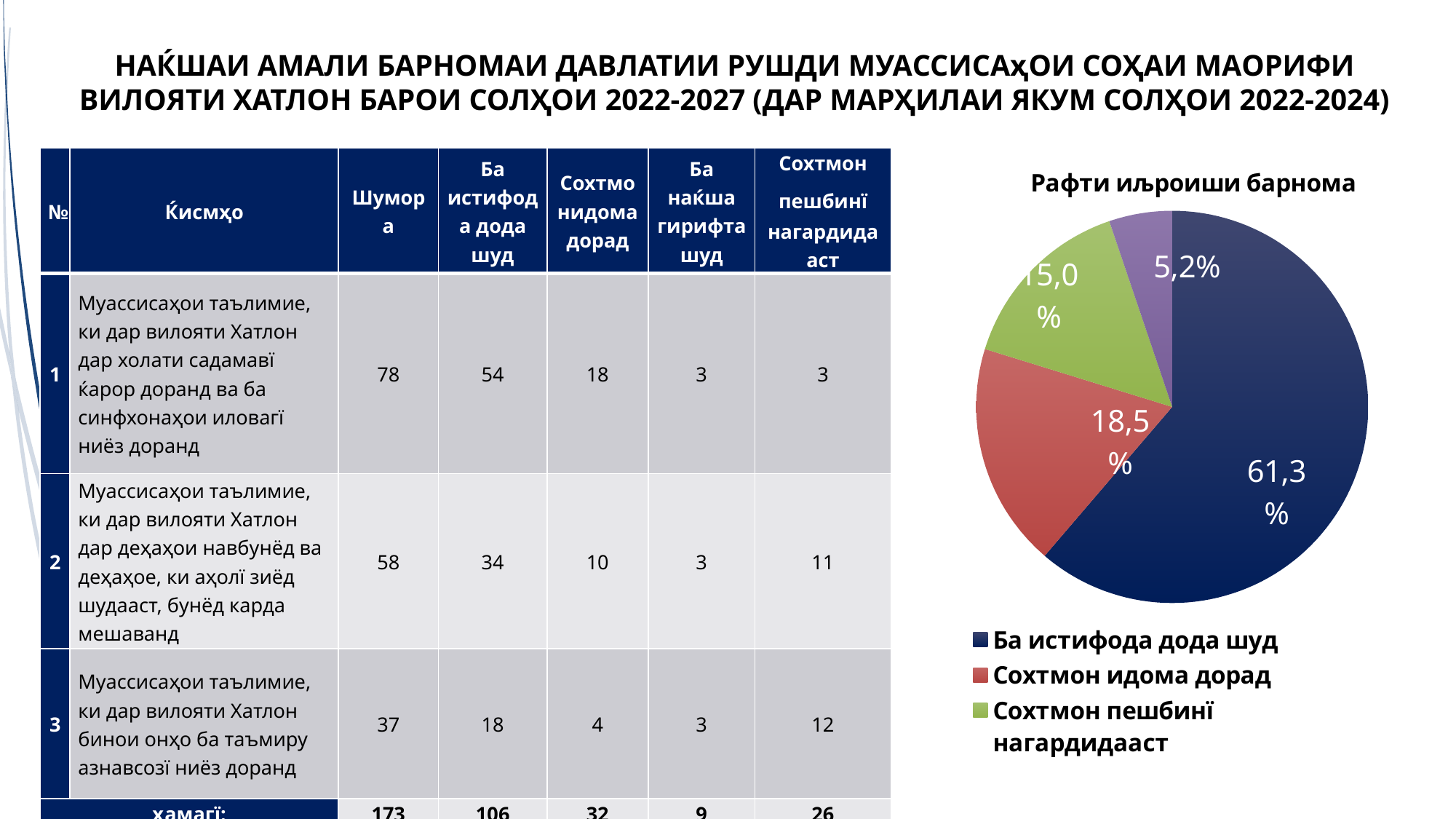
How many slices does the pie chart have? 4 What colour is the slice for 'Сохтмон пешбинї нагардидааст' in the pie chart? green What percentage does the slice 'Сохтмон идома дорад' represent in the pie chart? 18,5% What is the difference in percentage points between 'Ба истифода дода шуд' and 'Сохтмон идома дорад'? 42,8 What type of chart is shown on the slide? pie chart What percentage does the slice 'Ба истифода дода шуд' represent in the pie chart? 61,3% Which is larger in the pie chart: 'Сохтмон идома дорад' or 'Сохтмон пешбинї нагардидааст'? Сохтмон идома дорад What is the smallest percentage value shown on the pie chart? 5,2% What is the title of the chart on the slide? Рафти иљроиши барнома Which slice of the pie chart is the largest? Ба истифода дода шуд What percentage does the slice 'Сохтмон пешбинї нагардидааст' represent in the pie chart? 15,0% How many entries does the legend of the pie chart list? 3